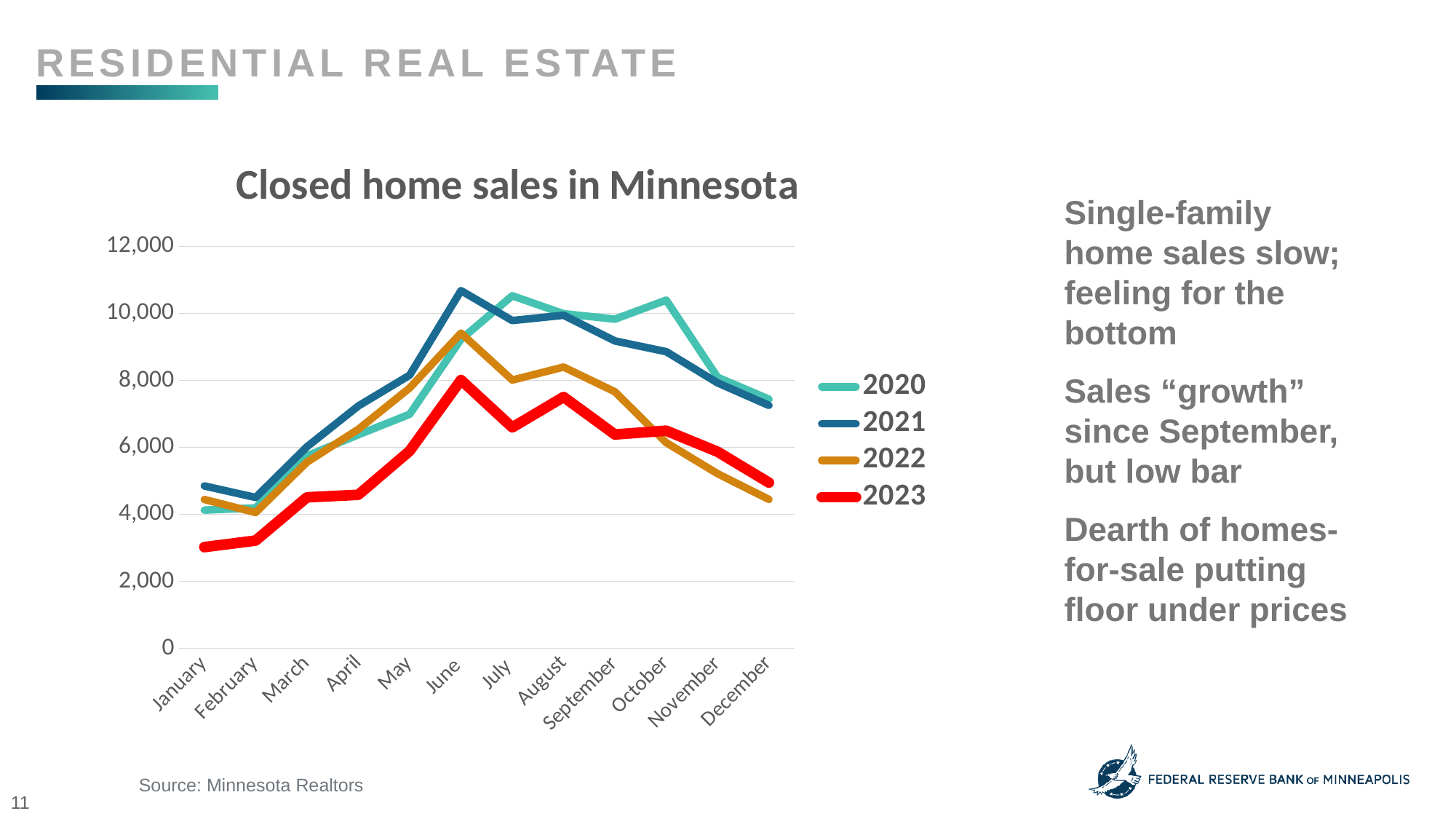
Is the value for 2021 in June greater or less than 10,000? greater Which year has the highest value in June? 2021 How many months are plotted along the x axis? 12 How many series does the legend list? 4 Is the value for 2022 in December greater or less than 6,000? less Is the value for 2023 in January greater or less than 4,000? less What kind of chart is shown on the slide? line chart In which month does the 2023 line reach its highest value? June What is the title of the chart? Closed home sales in Minnesota In which month is the 2023 line at its lowest value? January Which year has the lowest value in January? 2023 Which colour is used for the 2023 line? red